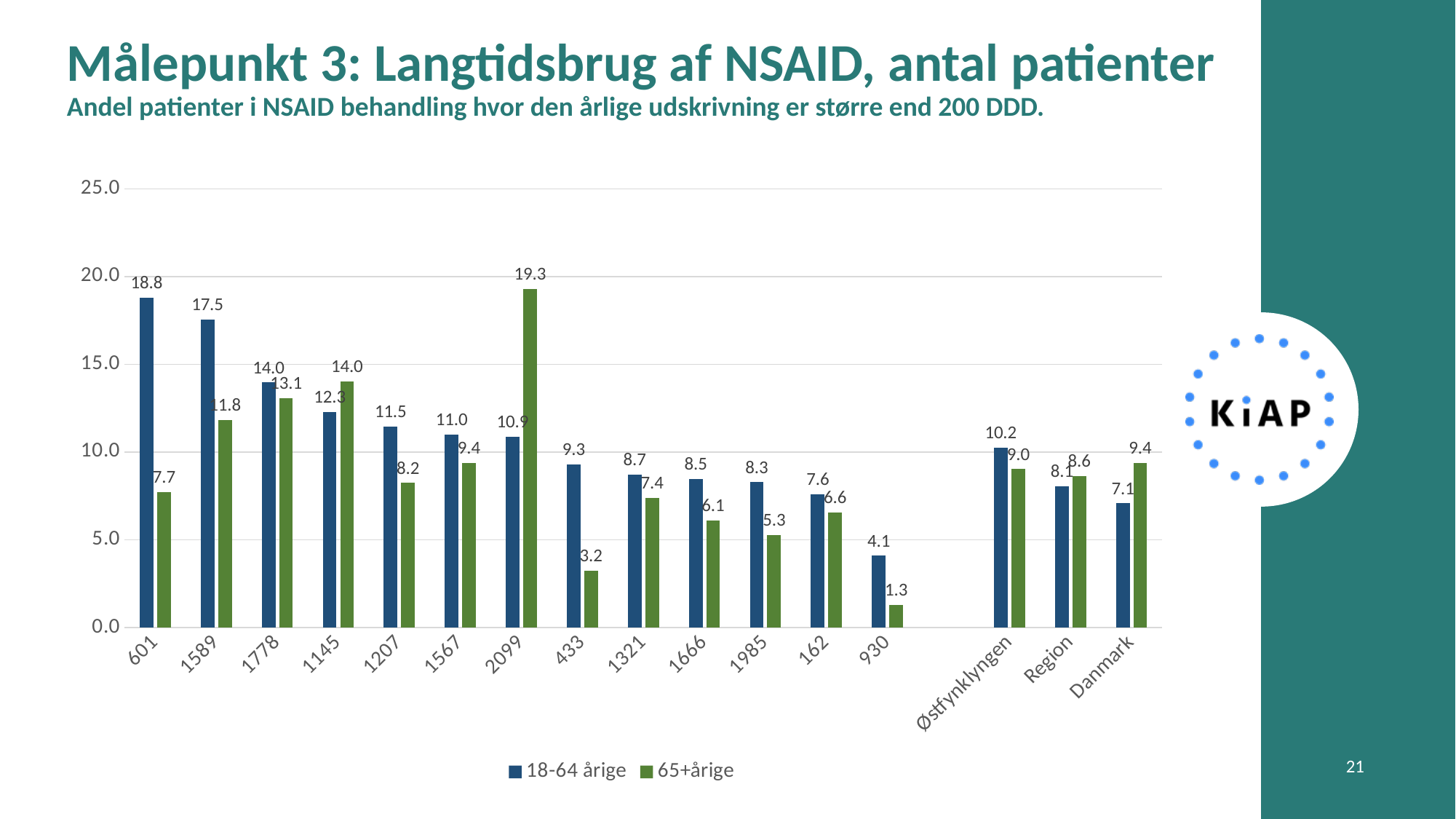
How many categories are shown on the x axis? 16 What colour represents the 65+årige series? green What is the value for the 65+årige series for category 2099? 19.3 What is the value for the 18-64 årige series for category 601? 18.8 How many series does the legend list? 2 For category 1145, which series has the larger value, 18-64 årige or 65+årige? 65+årige Which category has the lowest value in the 18-64 årige series? 930 What is the value for the 65+årige series for Danmark? 9.4 What kind of chart is shown on the slide? bar chart What is the difference between the 18-64 årige and 65+årige values for category 433? 6.1 Is the 18-64 årige value for category 1589 greater or less than 15.0? greater Which category has the highest value in the 65+årige series? 2099